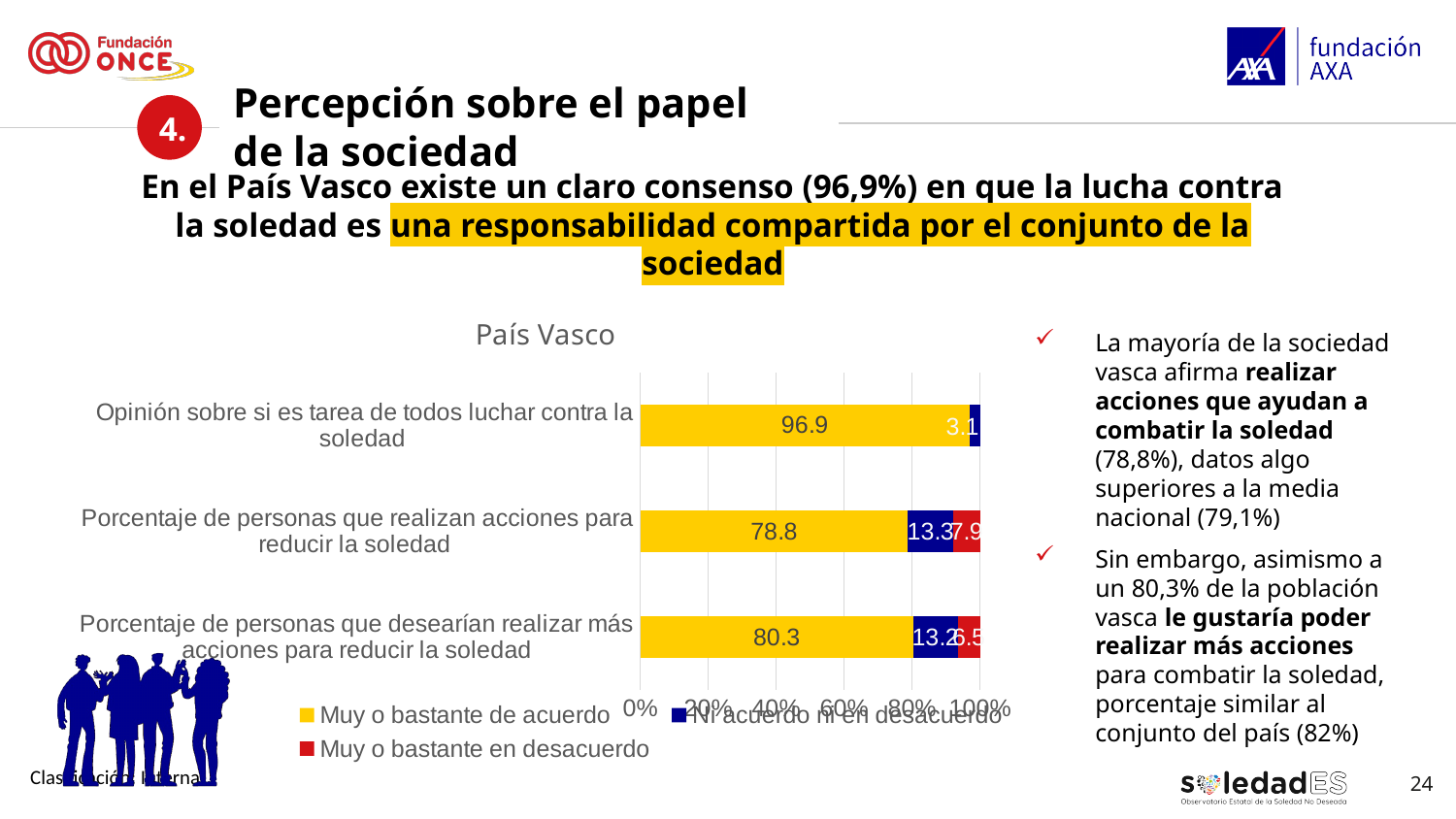
What is the value of 'Muy o bastante de acuerdo' for 'Porcentaje de personas que realizan acciones para reducir la soledad'? 78.8 How many categories are plotted in the chart? 3 Which has the larger 'Muy o bastante de acuerdo' value: 'Porcentaje de personas que realizan acciones para reducir la soledad' or 'Porcentaje de personas que desearían realizar más acciones para reducir la soledad'? Porcentaje de personas que desearían realizar más acciones para reducir la soledad What kind of chart is shown on the slide? Bar chart Which category has the lowest value for 'Muy o bastante de acuerdo'? Porcentaje de personas que realizan acciones para reducir la soledad What is the value of 'Muy o bastante de acuerdo' for 'Opinión sobre si es tarea de todos luchar contra la soledad'? 96.9 How many series does the chart legend list? 3 What is the value of 'Muy o bastante de acuerdo' for 'Porcentaje de personas que desearían realizar más acciones para reducir la soledad'? 80.3 What is the title of the chart? País Vasco What is the value of 'Ni acuerdo ni en desacuerdo' for 'Porcentaje de personas que realizan acciones para reducir la soledad'? 13.3 What is the difference between the 'Muy o bastante de acuerdo' values for 'Opinión sobre si es tarea de todos luchar contra la soledad' and 'Porcentaje de personas que realizan acciones para reducir la soledad'? 18.1 Which category has the highest value for 'Muy o bastante de acuerdo'? Opinión sobre si es tarea de todos luchar contra la soledad